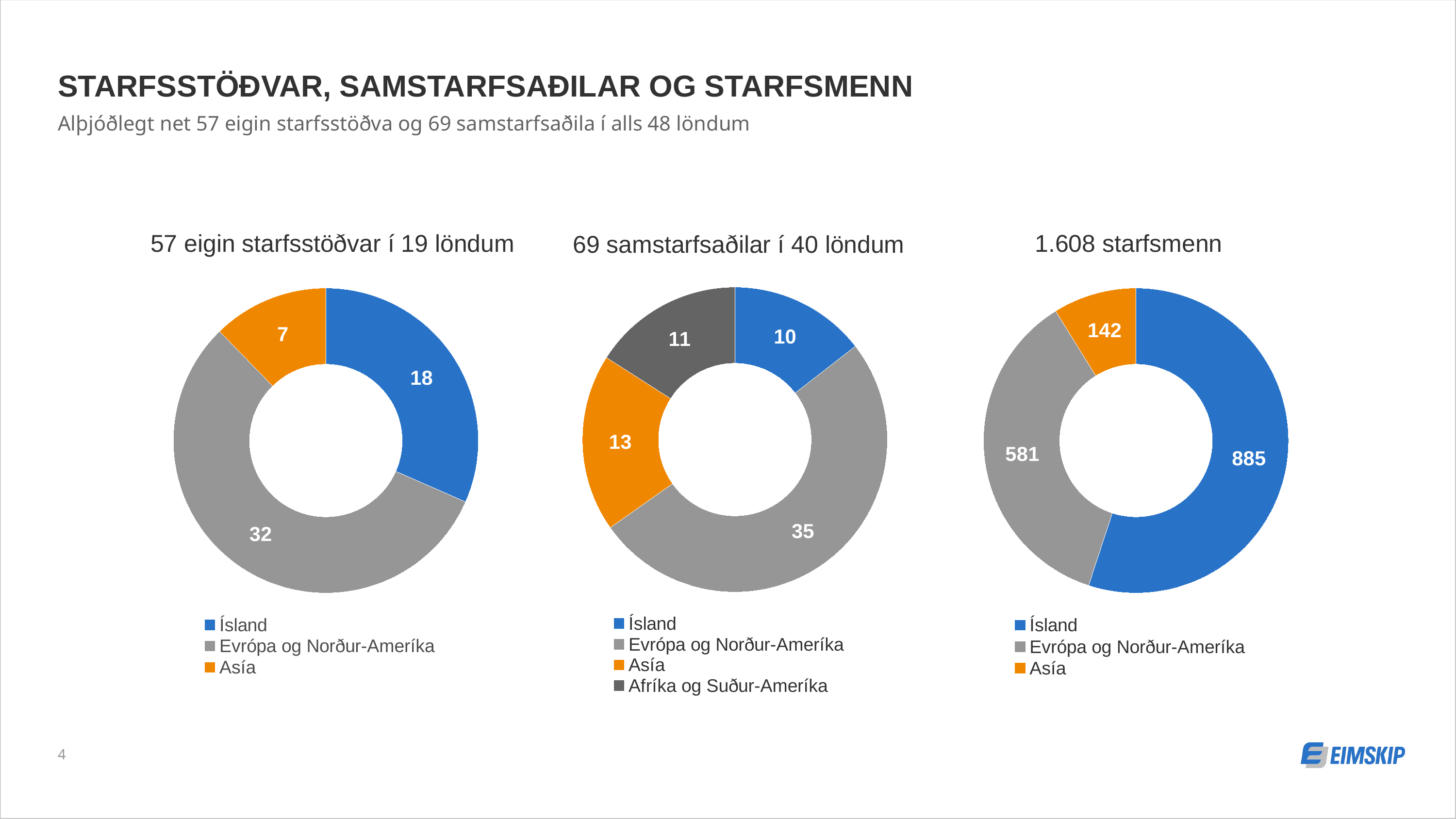
In the chart titled "1.608 starfsmenn", what is the value for Ísland? 885 In the chart titled "1.608 starfsmenn", which category has the smallest value? Asía In the chart titled "57 eigin starfsstöðvar í 19 löndum", what is the value for Evrópa og Norður-Ameríka? 32 In the chart titled "69 samstarfsaðilar í 40 löndum", how many categories are shown? 4 In the chart titled "57 eigin starfsstöðvar í 19 löndum", what is the difference between the values for Evrópa og Norður-Ameríka and Ísland? 14 In the chart titled "69 samstarfsaðilar í 40 löndum", which is larger: the value for Asía or the value for Afríka og Suður-Ameríka? Asía In the chart titled "57 eigin starfsstöðvar í 19 löndum", which category has the smallest value? Asía In the chart titled "69 samstarfsaðilar í 40 löndum", which category has the largest value? Evrópa og Norður-Ameríka In the chart titled "1.608 starfsmenn", what is the difference between the values for Ísland and Evrópa og Norður-Ameríka? 304 In the chart titled "69 samstarfsaðilar í 40 löndum", what is the value for Asía? 13 In the chart titled "69 samstarfsaðilar í 40 löndum", which colour represents Afríka og Suður-Ameríka? Dark grey What kind of chart is the chart titled "1.608 starfsmenn"? Doughnut chart